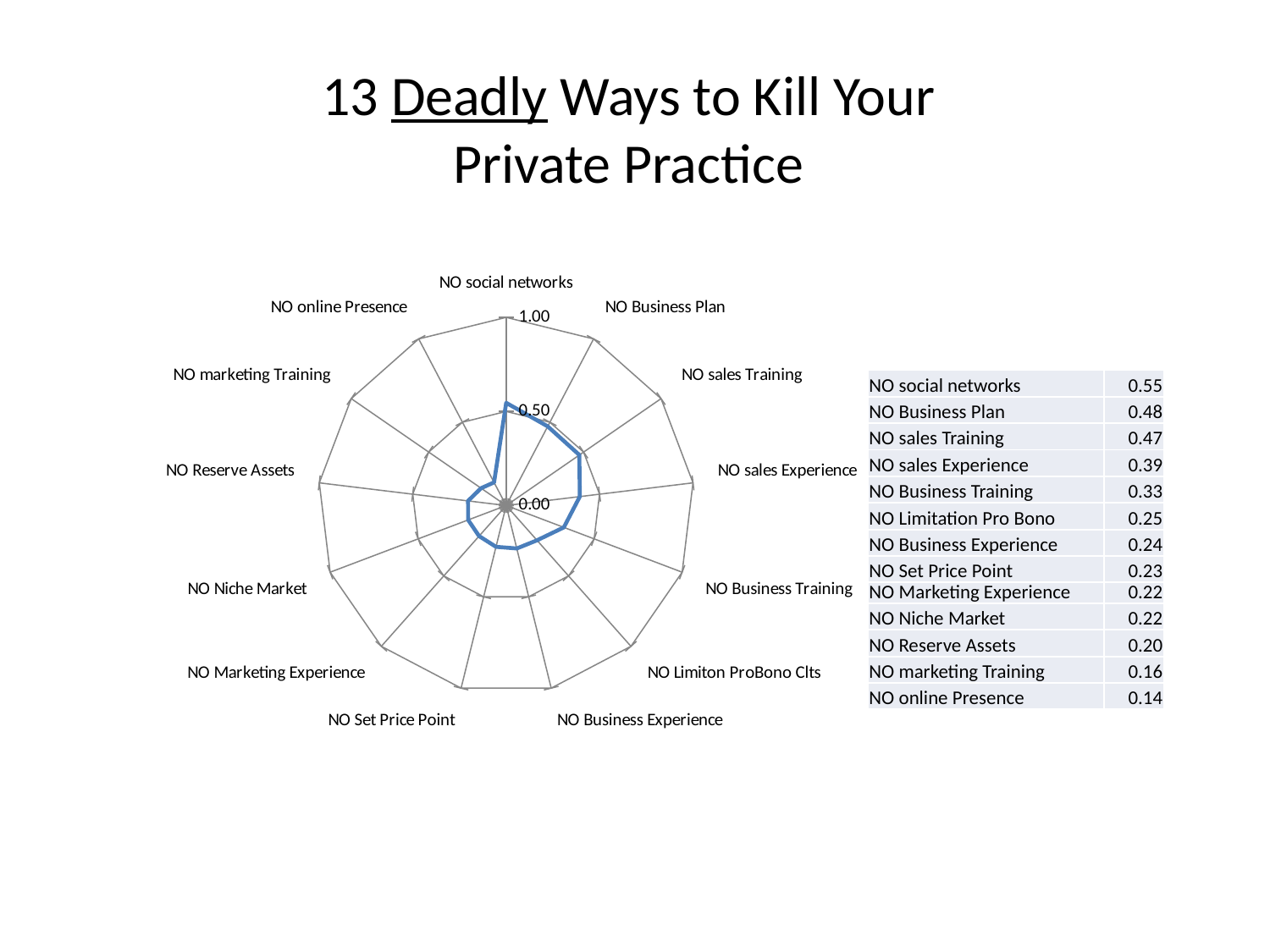
What is the maximum value shown on the radar chart's axis? 1.00 How many categories are plotted on the radar chart? 13 What is the value for NO Business Plan? 0.48 Which category has the highest value? NO social networks Is the value for NO social networks greater or less than 0.50? greater What is the value for NO Reserve Assets? 0.20 What is the value for NO Business Training? 0.33 Which category has the lowest value? NO online Presence Which is larger, the value for NO Business Plan or the value for NO Business Training? NO Business Plan What is the difference between the values for NO sales Training and NO sales Experience? 0.08 What kind of chart is shown on the slide? radar chart What is the difference between the values for NO social networks and NO online Presence? 0.41